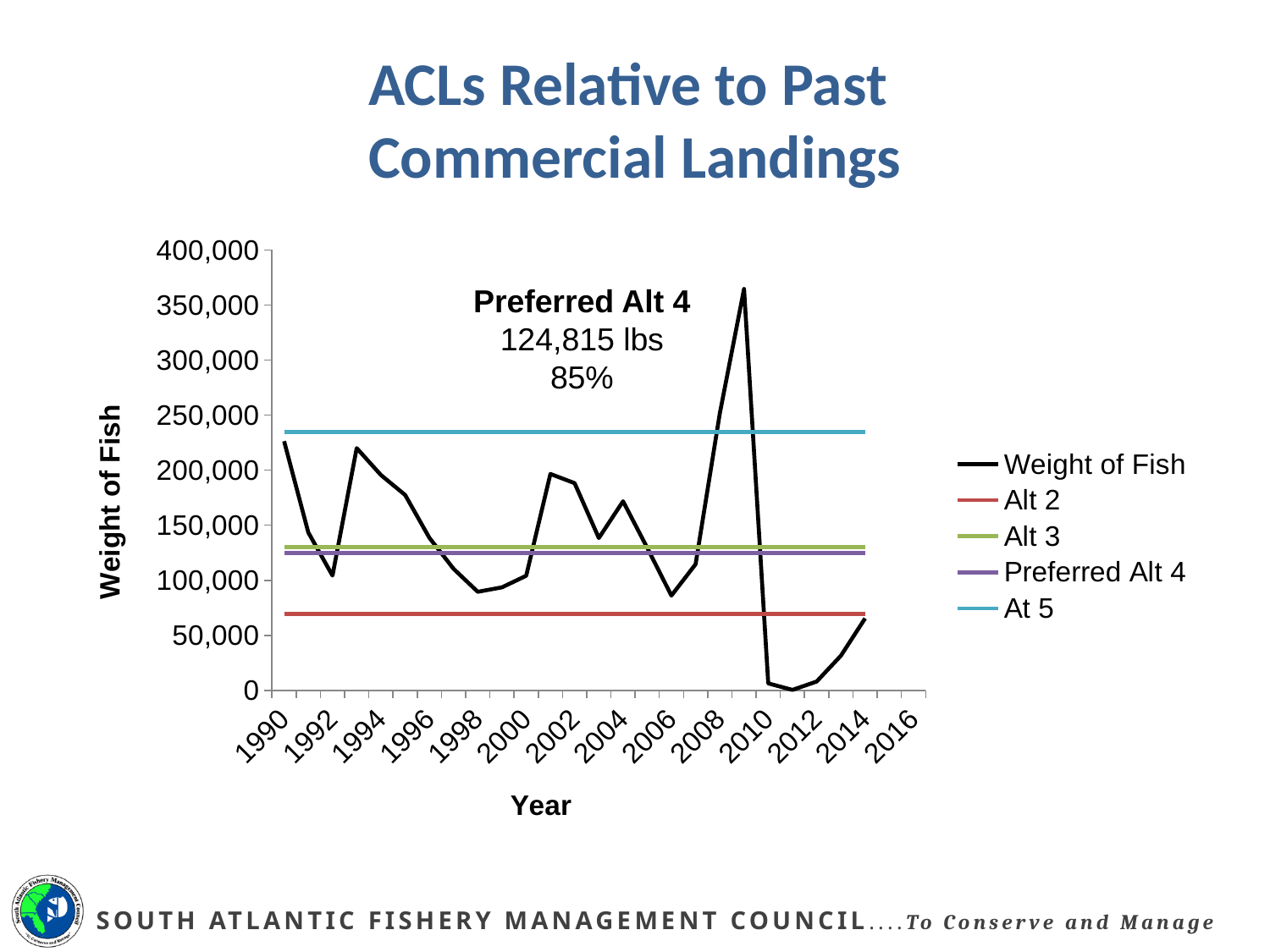
Is the At 5 line greater or less than 200,000? greater Which is larger, the Weight of Fish in 1990 or in 1992? 1990 In which year does the Weight of Fish line reach its highest value? 2009 Is the Weight of Fish value in 2009 greater or less than 300,000? greater What percentage is shown in the annotation for Preferred Alt 4? 85% What type of chart is shown on the slide? Line chart Does the Weight of Fish line rise or fall between 2009 and 2011? Fall What value in lbs is given for Preferred Alt 4 in the chart annotation? 124,815 lbs What is the title of the vertical axis? Weight of Fish In which year does the Weight of Fish line reach its lowest value? 2011 Is the Alt 2 line greater or less than 100,000? less How many series does the legend list? 5